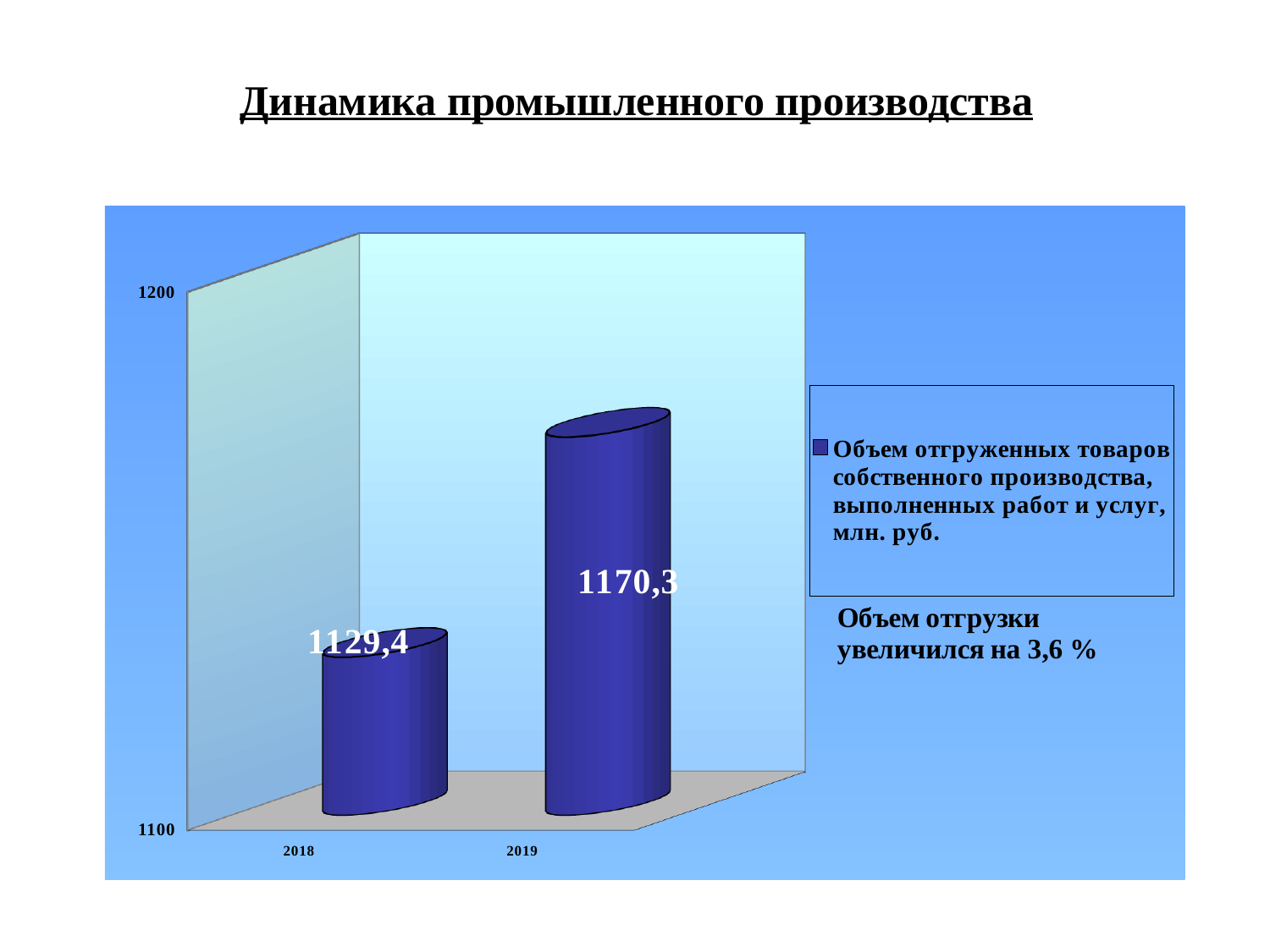
What is the difference between the 2019 and 2018 values? 40,9 Which year has the higher value? 2019 How many years are shown on the x axis? 2 How many series does the legend list? 1 What kind of chart is shown on the slide? bar chart Is the value for 2019 greater or less than the value for 2018? greater What is the value for 2018? 1129,4 What is the value for 2019? 1170,3 Which year has the lower value? 2018 Do the values rise or fall from 2018 to 2019? rise What is the title of the slide? Динамика промышленного производства Is the value for 2018 greater or less than 1200? less